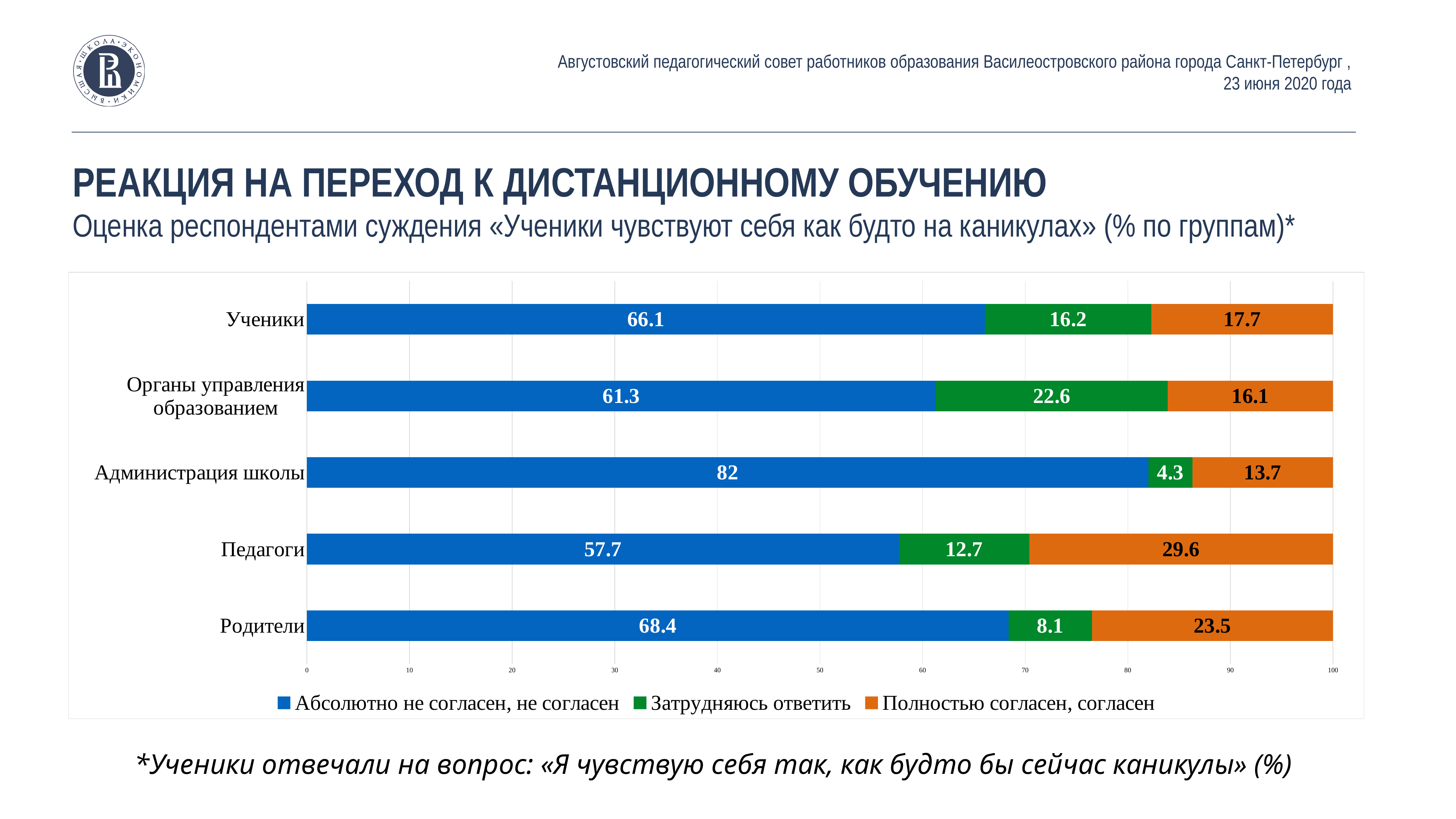
Which group has the highest value for «Абсолютно не согласен, не согласен»? Администрация школы What is the difference between the «Полностью согласен, согласен» values for Педагоги and Родители? 6.1 What is the total of the stacked bar for Родители? 100 What is the value of «Абсолютно не согласен, не согласен» for Администрация школы? 82 How many groups (categories) are shown on the chart? 5 Which is larger: the «Затрудняюсь ответить» value for Ученики or for Родители? Ученики What is the value of «Полностью согласен, согласен» for Педагоги? 29.6 Which series is shown in orange in the legend? Полностью согласен, согласен How many series does the legend list? 3 Which group has the lowest value for «Затрудняюсь ответить»? Администрация школы What type of chart is shown on the slide? stacked bar chart What is the value of «Затрудняюсь ответить» for Органы управления образованием? 22.6